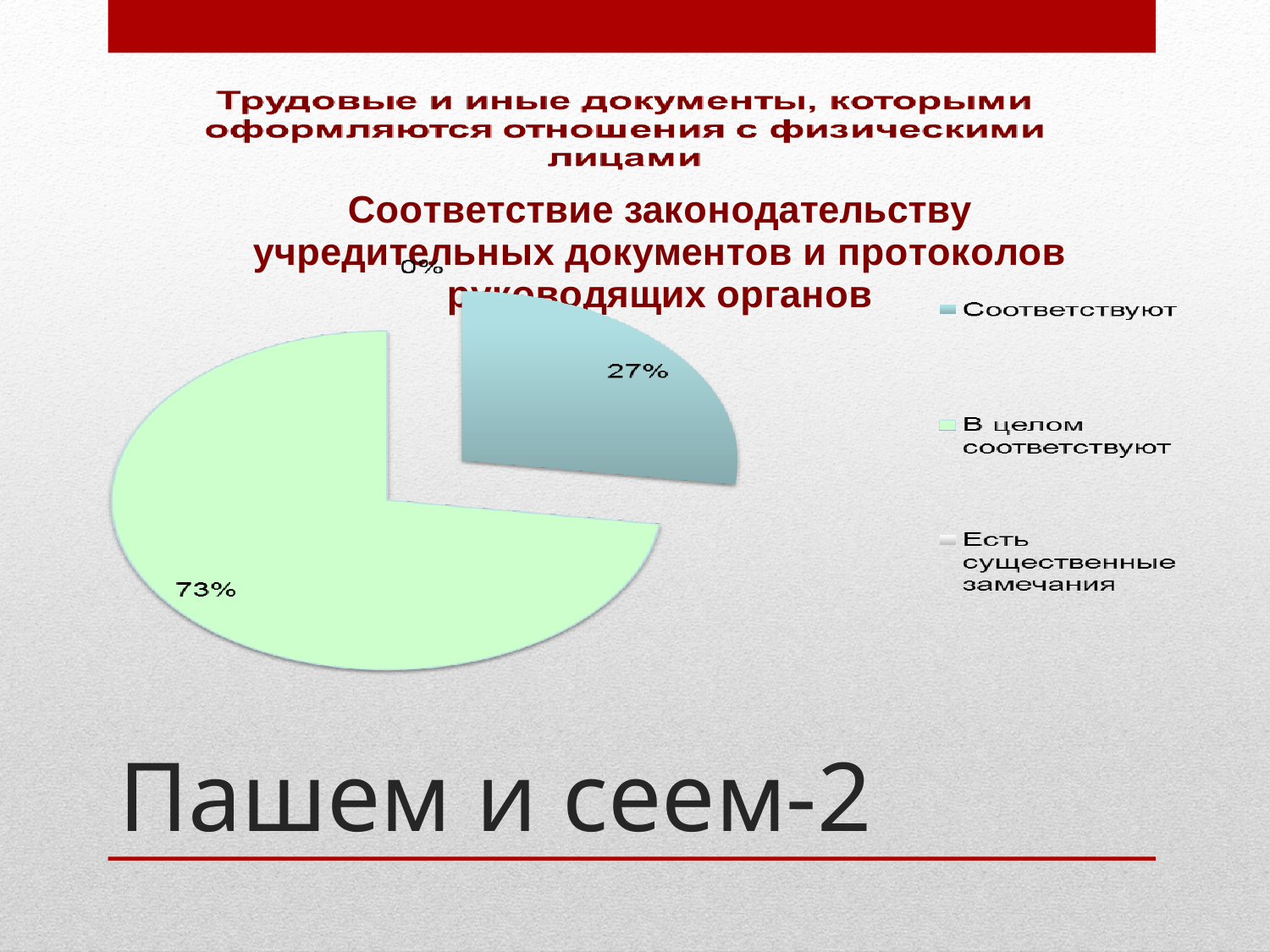
What is the difference in percentage points between "В целом соответствуют" and "Соответствуют"? 46 Which category has the smallest slice of the pie? Есть существенные замечания Which category has the largest slice of the pie? В целом соответствуют What colour is the slice for "В целом соответствуют"? light green What is the title of the pie chart? Соответствие законодательству учредительных документов и протоколов руководящих органов What kind of chart is shown on the slide? pie chart What share of the pie does "Соответствуют" have? 27% Which is larger: the slice for "Соответствуют" or the slice for "В целом соответствуют"? В целом соответствуют How many categories does the legend of the pie chart list? 3 What share of the pie does "Есть существенные замечания" have? 0% What share of the pie does "В целом соответствуют" have? 73% Is the share for "Соответствуют" greater or less than 50%? less